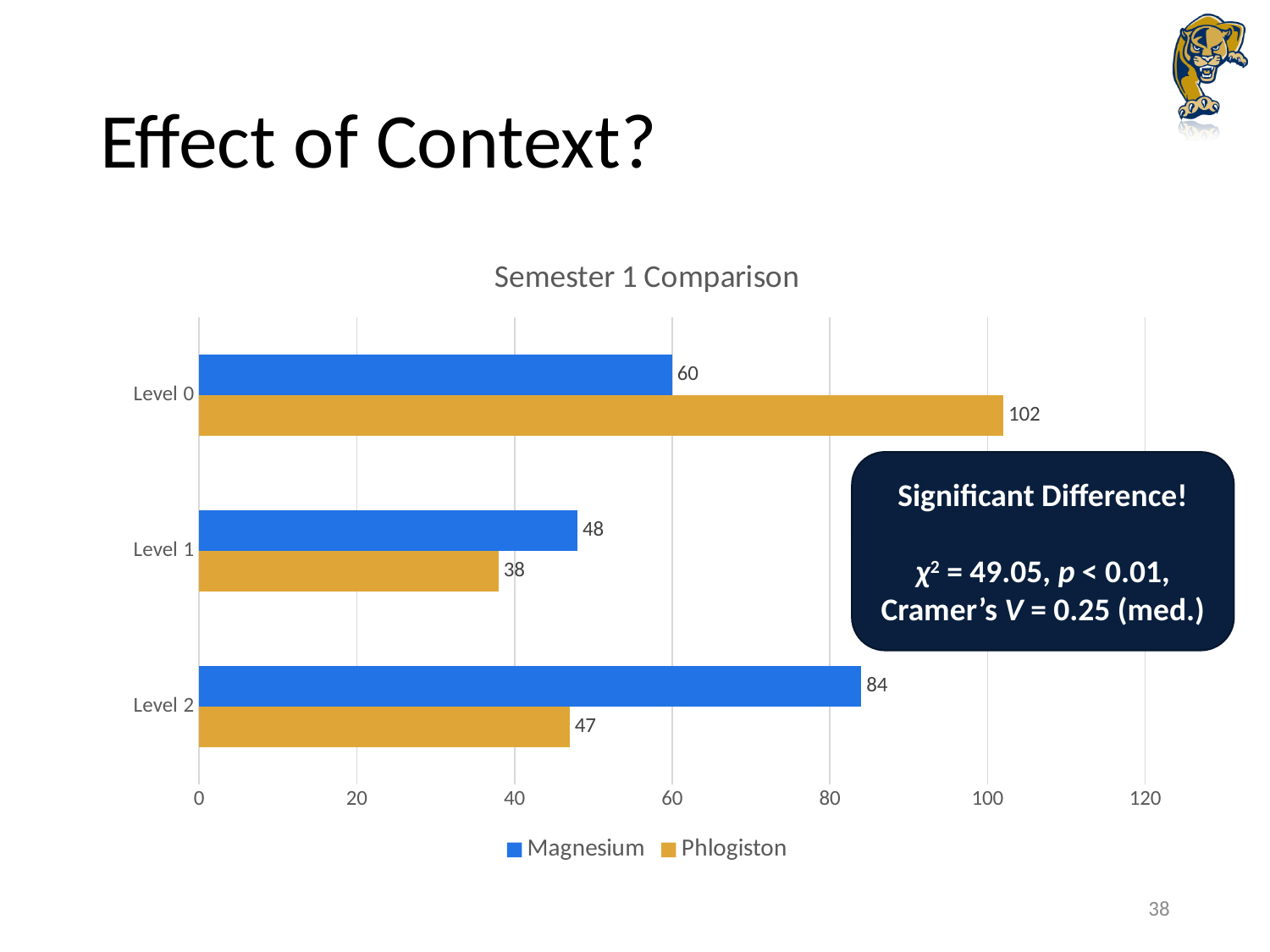
What is the difference between the Phlogiston and Magnesium values for Level 0? 42 What is the Magnesium value for Level 2? 84 What kind of chart is shown on the slide? Bar chart Which level has the highest Magnesium value? Level 2 What is the Phlogiston value for Level 1? 38 How many levels (categories) are shown on the chart? 3 What is the Phlogiston value for Level 0? 102 How many series does the legend list? 2 What is the title of the chart? Semester 1 Comparison What is the Magnesium value for Level 0? 60 Which level has the lowest Phlogiston value? Level 1 For Level 2, which series has the larger value, Magnesium or Phlogiston? Magnesium